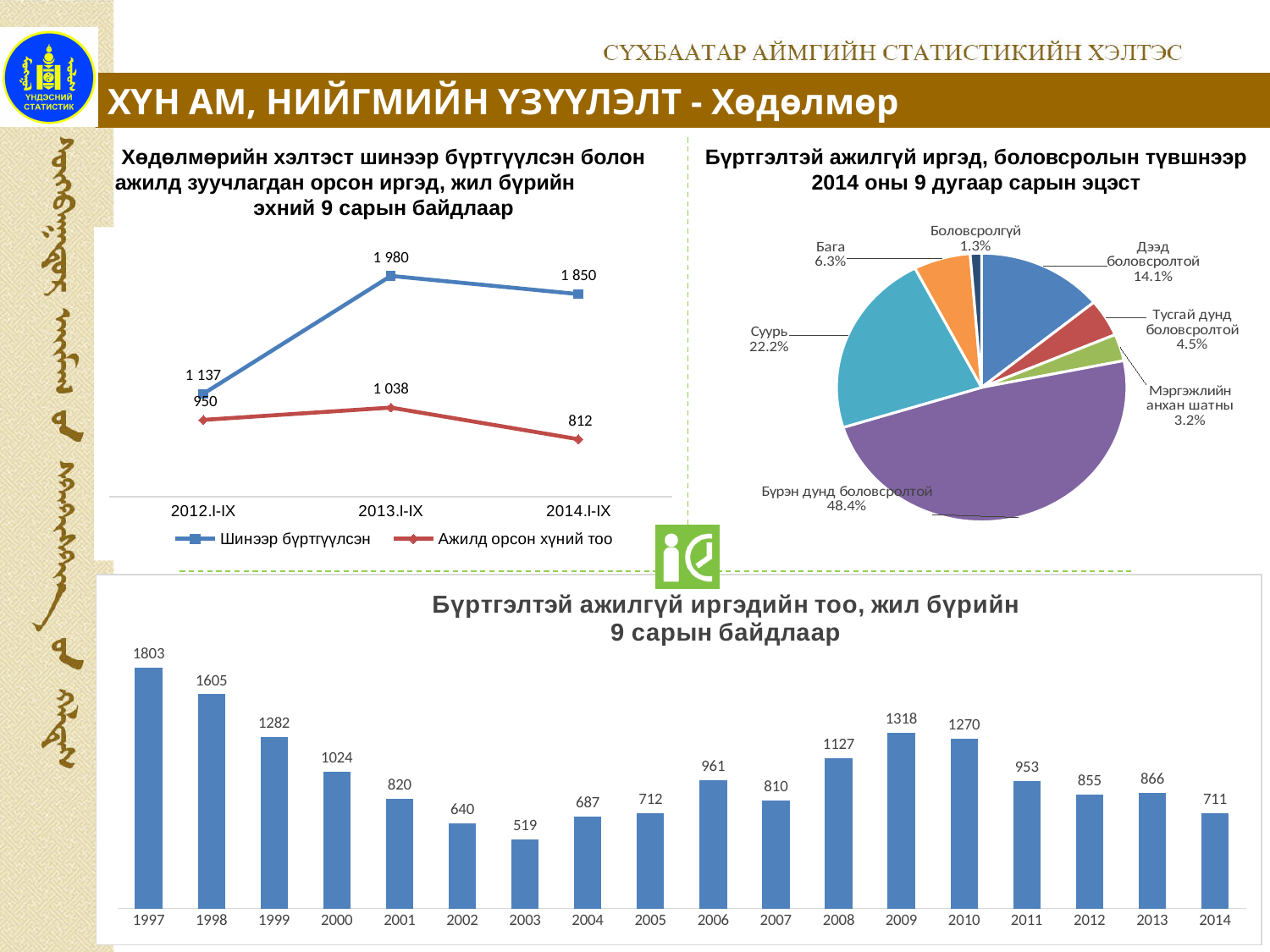
In the bottom chart (Бүртгэлтэй ажилгүй иргэдийн тоо), which year has the highest value? 1997 In the bottom chart (Бүртгэлтэй ажилгүй иргэдийн тоо), what kind of chart is it? Bar chart In the top-left line chart, what is the difference between Шинээр бүртгүүлсэн and Ажилд орсон хүний тоо for 2012.I-IX? 187 In the bottom chart (Бүртгэлтэй ажилгүй иргэдийн тоо), how many years are shown? 18 In the top-left line chart, what is the value of Ажилд орсон хүний тоо for 2014.I-IX? 812 In the top-right pie chart, which category has the smallest share? Боловсролгүй In the top-left line chart, what is the value of Шинээр бүртгүүлсэн for 2013.I-IX? 1 980 In the top-right pie chart, what share does Бүрэн дунд боловсролтой have? 48.4% In the bottom chart (Бүртгэлтэй ажилгүй иргэдийн тоо), what is the value for 2009? 1318 In the bottom chart (Бүртгэлтэй ажилгүй иргэдийн тоо), what is the difference between the values for 1997 and 2014? 1092 In the bottom chart (Бүртгэлтэй ажилгүй иргэдийн тоо), which year has the lowest value? 2003 In the top-left line chart, how many series does the legend list? 2